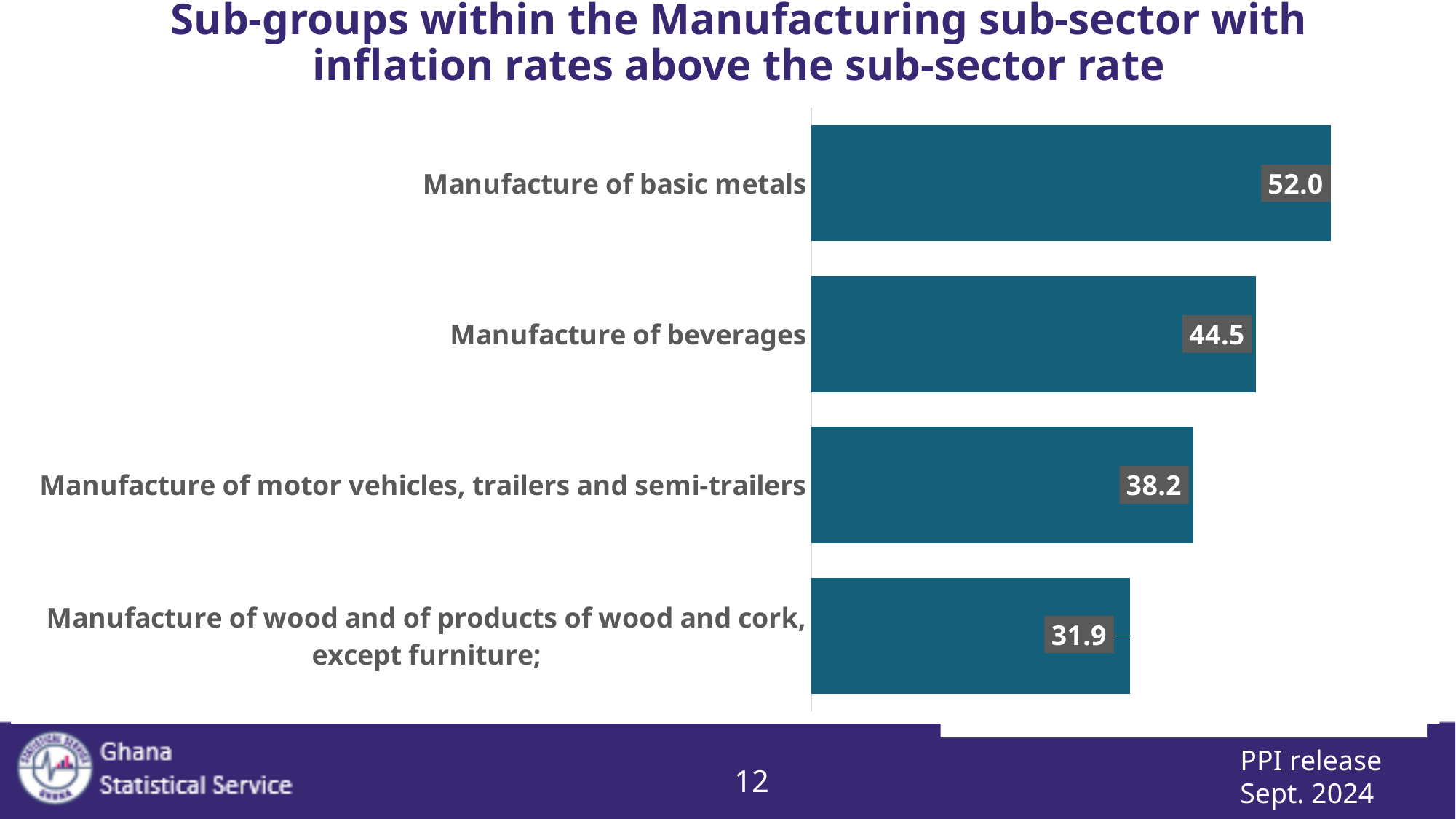
Which sub-group has the highest inflation rate? Manufacture of basic metals What is the title of the chart? Sub-groups within the Manufacturing sub-sector with inflation rates above the sub-sector rate What is the inflation rate for Manufacture of wood and of products of wood and cork, except furniture? 31.9 How many sub-groups are shown in the chart? 4 Which sub-group has the lowest inflation rate? Manufacture of wood and of products of wood and cork, except furniture What is the inflation rate for Manufacture of motor vehicles, trailers and semi-trailers? 38.2 What is the difference between the inflation rates for Manufacture of basic metals and Manufacture of beverages? 7.5 What is the inflation rate for Manufacture of beverages? 44.5 What kind of chart is shown on the slide? Bar chart What is the difference between the inflation rates for Manufacture of motor vehicles, trailers and semi-trailers and Manufacture of wood and of products of wood and cork, except furniture? 6.3 Which has a higher inflation rate: Manufacture of beverages or Manufacture of motor vehicles, trailers and semi-trailers? Manufacture of beverages What is the inflation rate for Manufacture of basic metals? 52.0